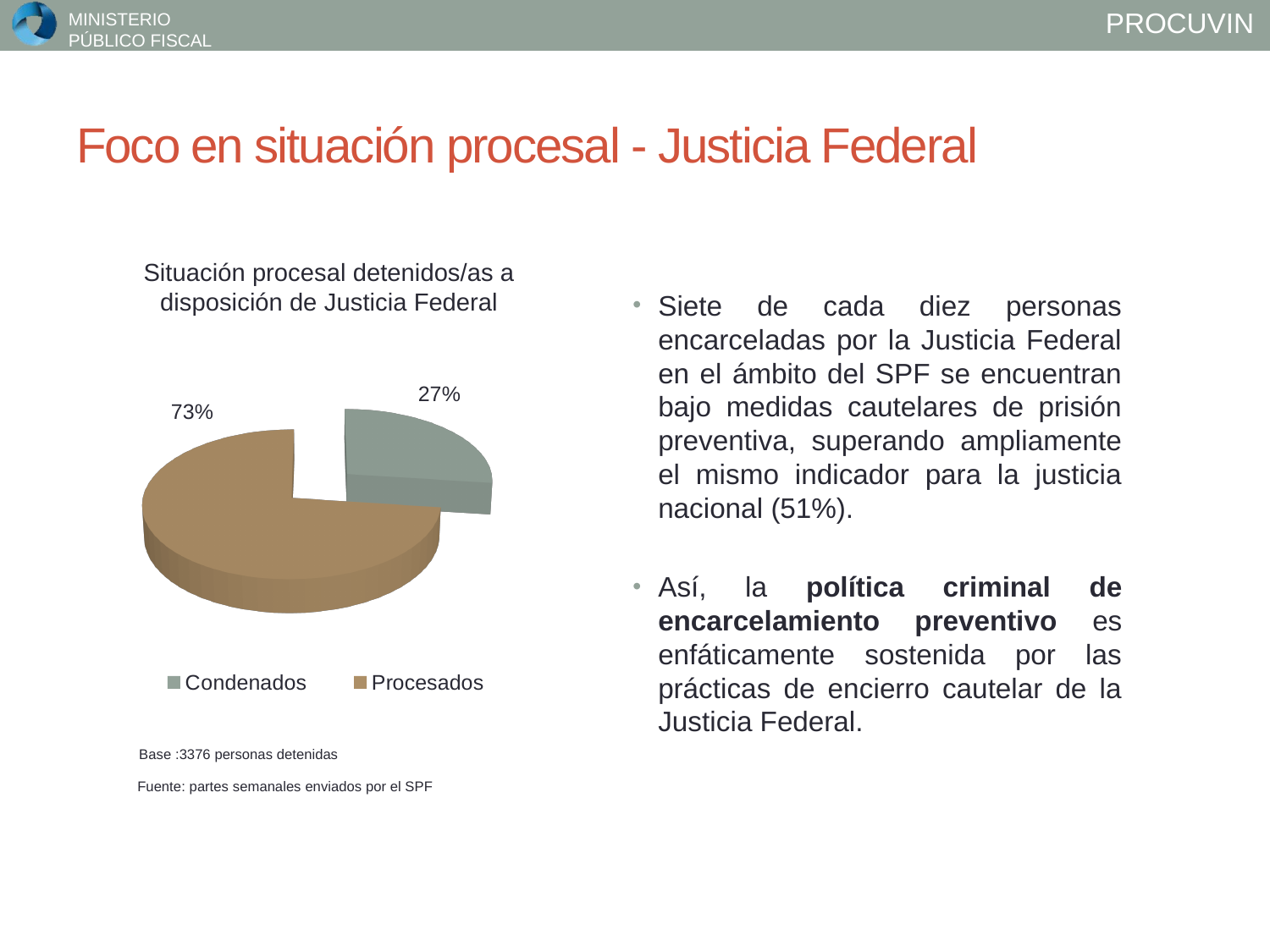
What percentage of the pie corresponds to Condenados? 27% Which is larger, the share for Condenados or the share for Procesados? Procesados What is the title of the chart? Situación procesal detenidos/as a disposición de Justicia Federal How many entries does the legend list? 2 How many categories does the pie chart show? 2 What percentage of the pie corresponds to Procesados? 73% Which category has the largest share of the pie? Procesados Which colour represents Procesados in the chart? Brown What is the share of the pie taken by the Condenados slice? 27% What kind of chart is shown on the slide? Pie chart Which category has the smallest share of the pie? Condenados What is the difference in percentage points between Procesados and Condenados? 46